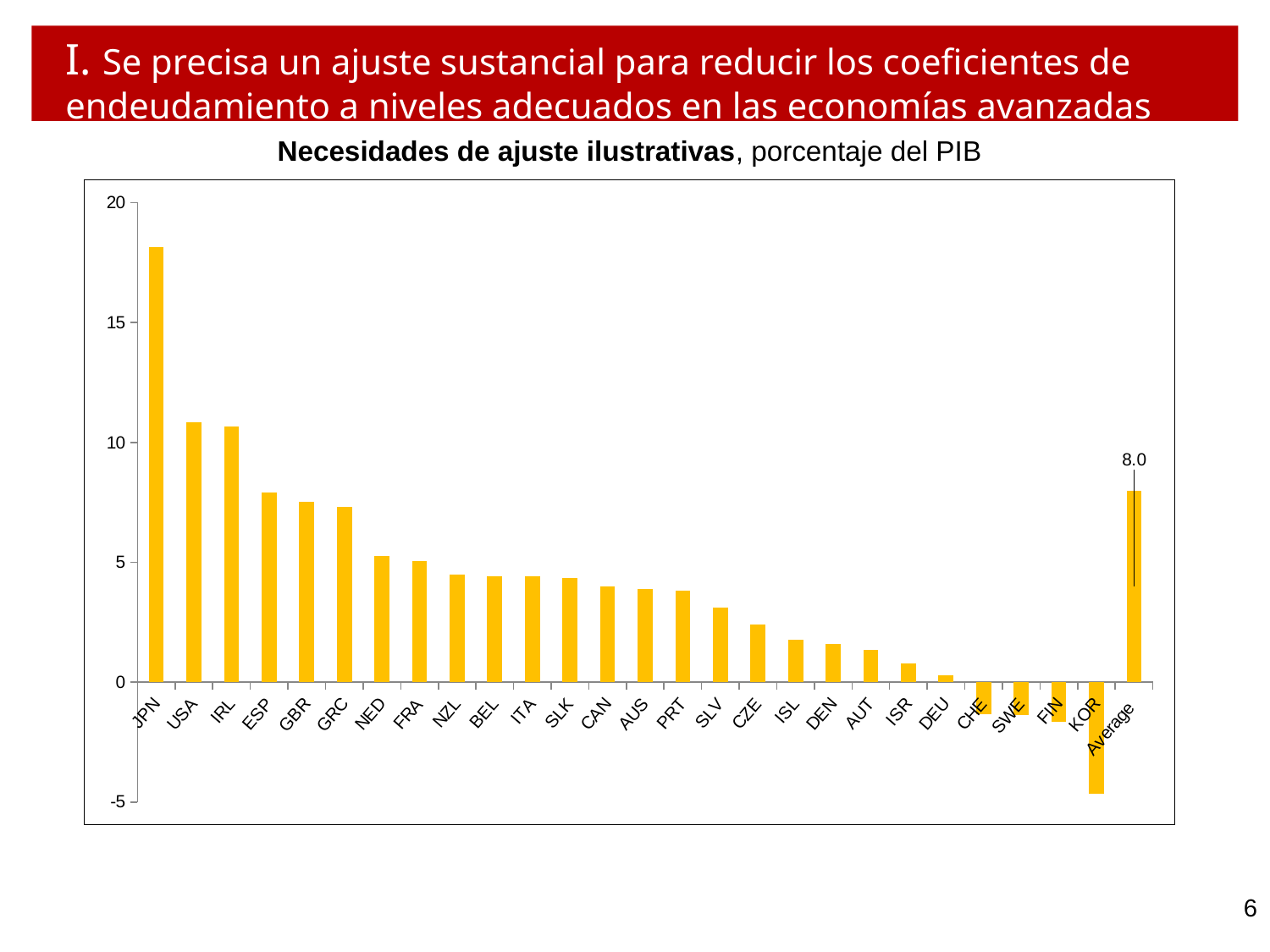
Which is larger, the value for NED or the value for CZE? NED How many bars are plotted in the chart, including Average? 27 Which country has the lowest adjustment need? KOR What kind of chart is shown on the slide? bar chart Is the value for JPN greater or less than 15? greater Do the country bars rise or fall from JPN to KOR along the x axis? fall Is the value for USA greater or less than 10? greater What is the value shown for Average? 8.0 Is the value for ESP greater or less than 5? greater Which is larger, the value for JPN or the value for USA? JPN Which country has the highest adjustment need? JPN